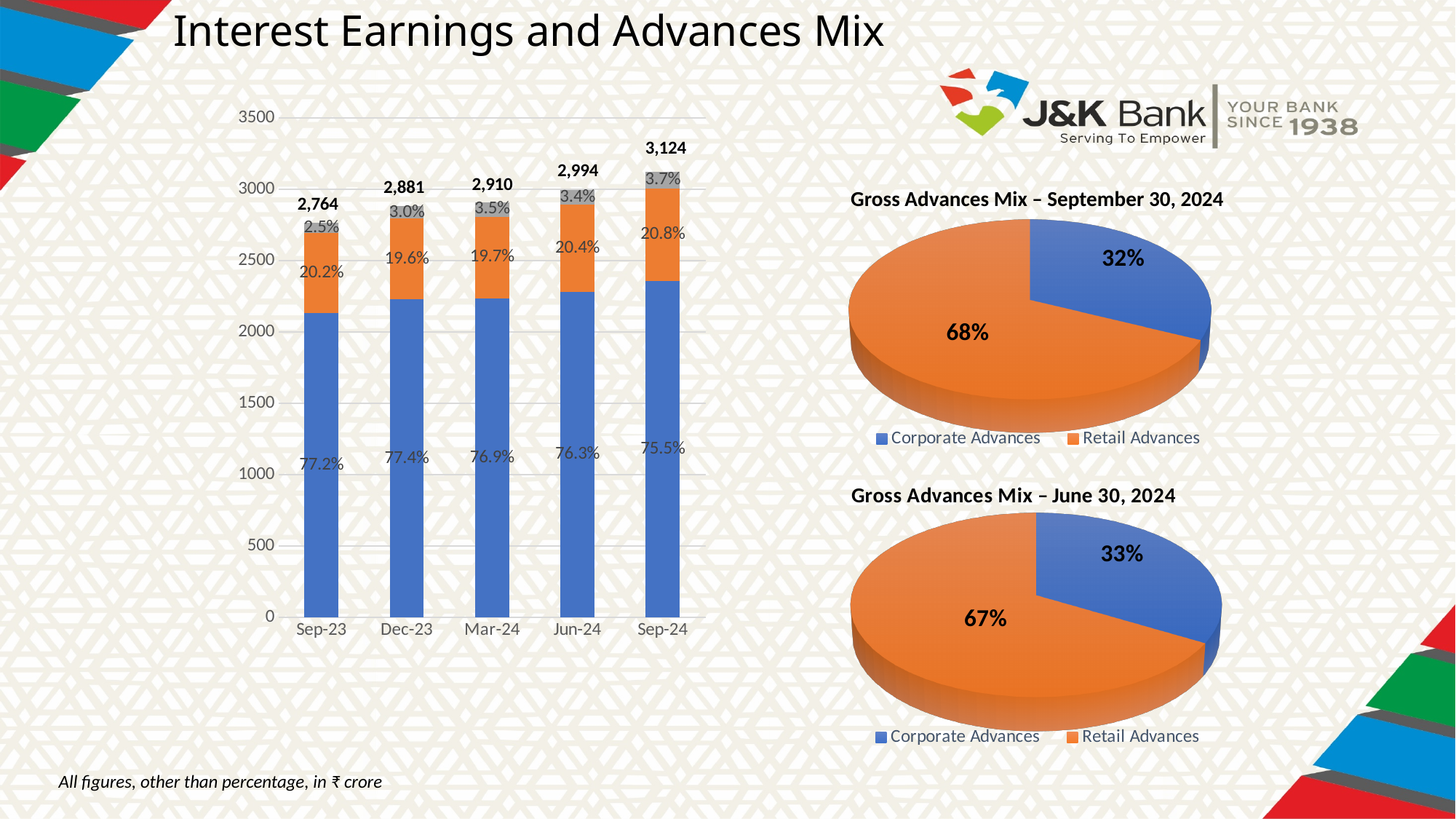
In the stacked bar chart on the left, which period has the highest total? Sep-24 In the 'Gross Advances Mix – September 30, 2024' pie chart, what share is Retail Advances? 68% In the stacked bar chart on the left, what percentage is labelled on the orange segment of the Sep-24 bar? 20.8% In the stacked bar chart on the left, what is the total value shown above the Sep-23 bar? 2,764 How many series does the legend of the 'Gross Advances Mix – June 30, 2024' chart list? 2 In the stacked bar chart on the left, do the bar totals rise or fall from Sep-23 to Sep-24? rise In the stacked bar chart on the left, what is the total value shown above the Sep-24 bar? 3,124 In the stacked bar chart on the left, what is the difference between the Sep-24 total and the Jun-24 total? 130 In the stacked bar chart on the left, what percentage is labelled on the blue segment of the Dec-23 bar? 77.4% In the stacked bar chart on the left, which period has the lowest total? Sep-23 In the stacked bar chart on the left, how many periods are shown on the x axis? 5 In the 'Gross Advances Mix – June 30, 2024' pie chart, what share is Corporate Advances? 33%